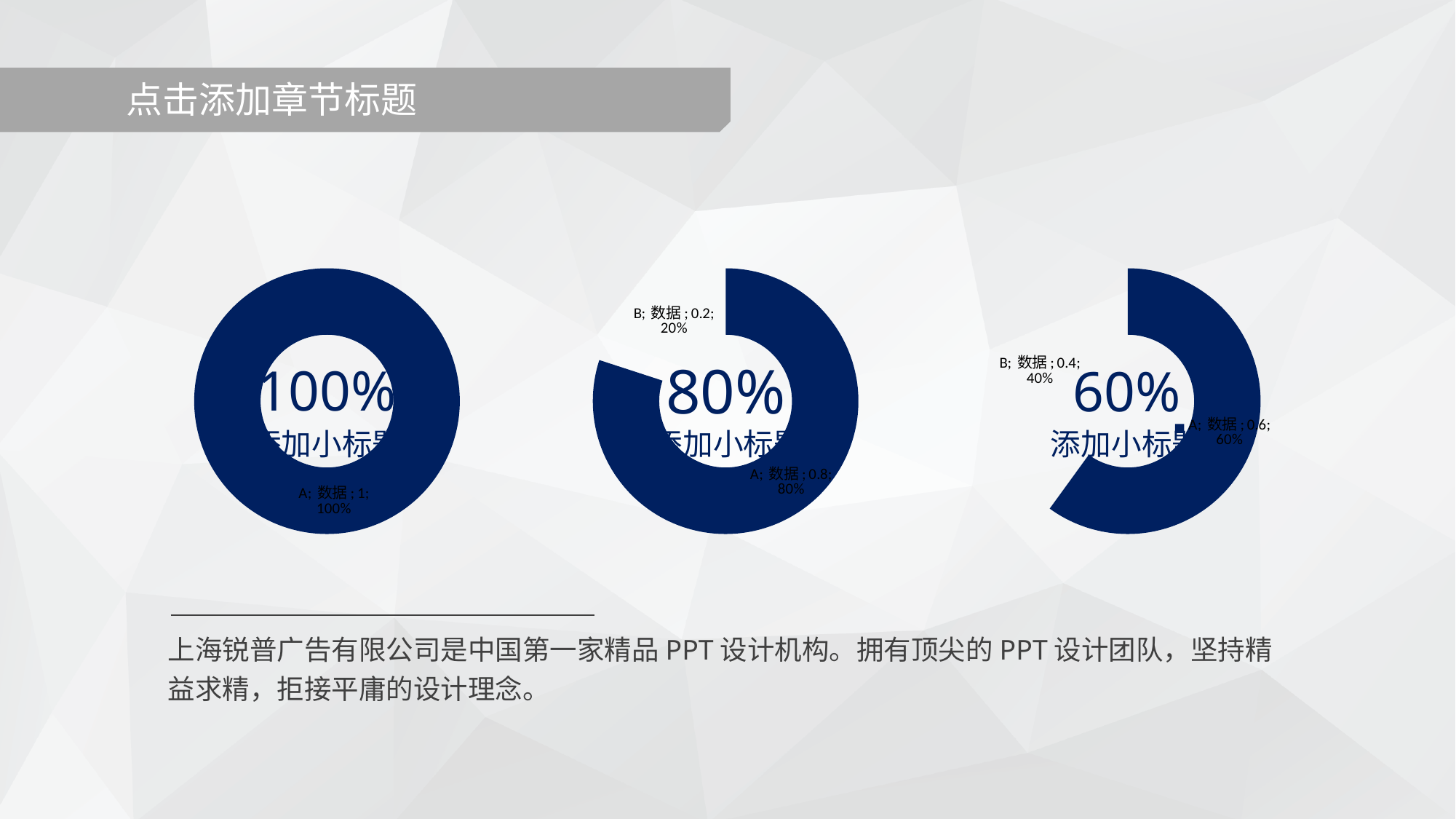
How many categories are labelled in the middle chart? 2 In the middle chart, which category has the larger share, A or B? A In the right chart, what percentage is shown for category B? 40% In the right chart, what value is shown for category A? 0.6 How many categories are labelled in the left chart? 1 In the left chart, what percentage is shown for category A? 100% In the middle chart, what percentage is shown for category A? 80% In the right chart, which category has the smallest share? B What large percentage is printed in the centre of the right chart? 60% In the right chart, what is the difference in percentage points between category A and category B? 20% In the middle chart, what percentage is shown for category B? 20% What kind of chart is the middle chart on the slide? Doughnut chart